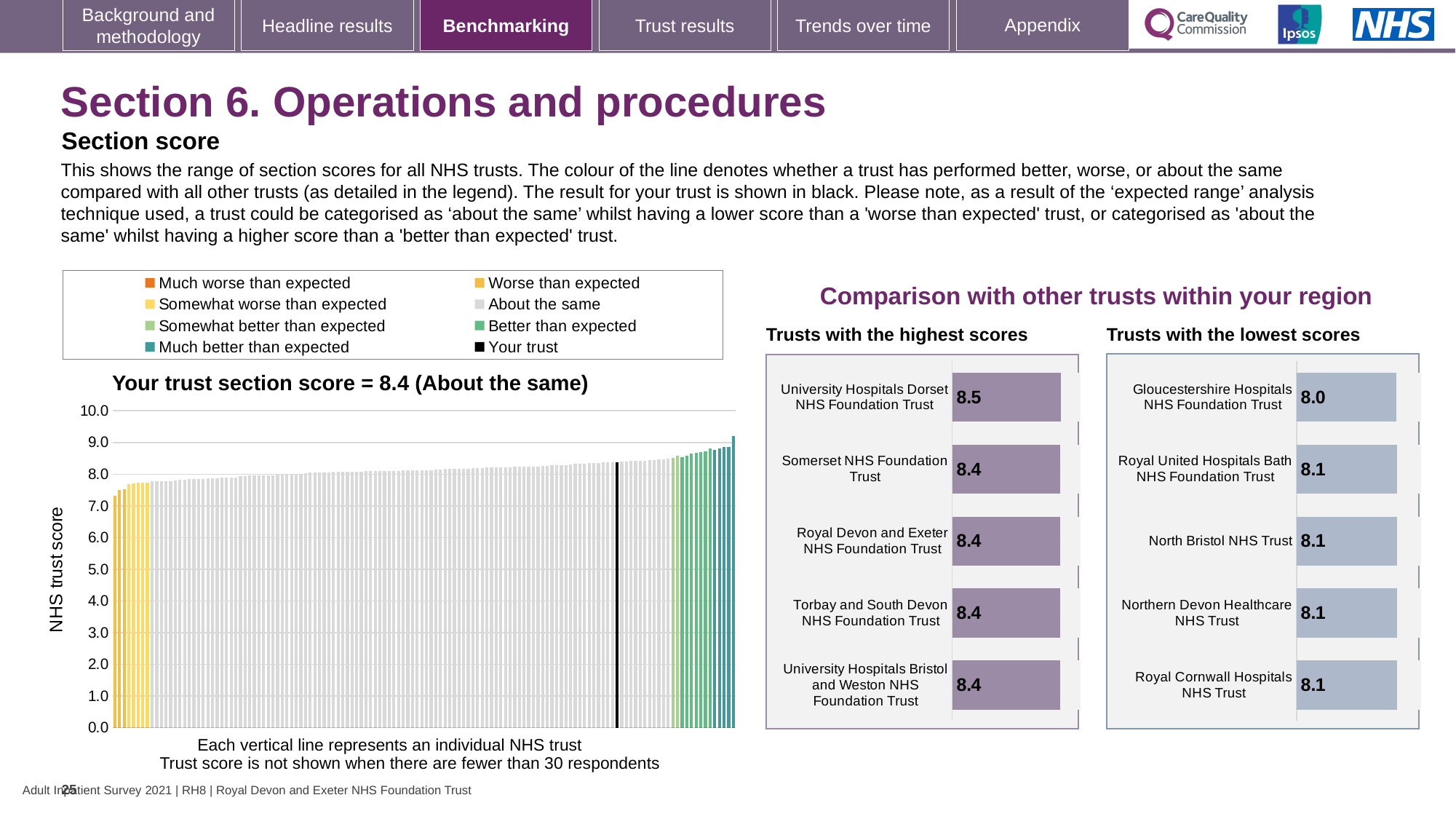
In the 'Trusts with the highest scores' chart, how many trusts are shown? 5 In the 'Trusts with the lowest scores' chart, what is the difference between the score for Royal Cornwall Hospitals NHS Trust and the score for Gloucestershire Hospitals NHS Foundation Trust? 0.1 What kind of chart is the 'Your trust section score' chart? bar chart In the 'Trusts with the highest scores' chart, what is the score for University Hospitals Dorset NHS Foundation Trust? 8.5 In the 'Your trust section score' chart, is the value of the leftmost (lowest) bar greater or less than 7.0? greater In the 'Your trust section score' chart, what is the section score for your trust? 8.4 In the 'Trusts with the lowest scores' chart, which trust has the lowest score? Gloucestershire Hospitals NHS Foundation Trust Which is larger: the score for University Hospitals Dorset NHS Foundation Trust in the 'Trusts with the highest scores' chart or the score for Gloucestershire Hospitals NHS Foundation Trust in the 'Trusts with the lowest scores' chart? University Hospitals Dorset NHS Foundation Trust In the 'Your trust section score' chart, do the bar values rise or fall from left to right? rise What is the y-axis label of the 'Your trust section score' chart? NHS trust score How many entries does the legend above the 'Your trust section score' chart list? 8 In the 'Trusts with the highest scores' chart, which trust has the highest score? University Hospitals Dorset NHS Foundation Trust